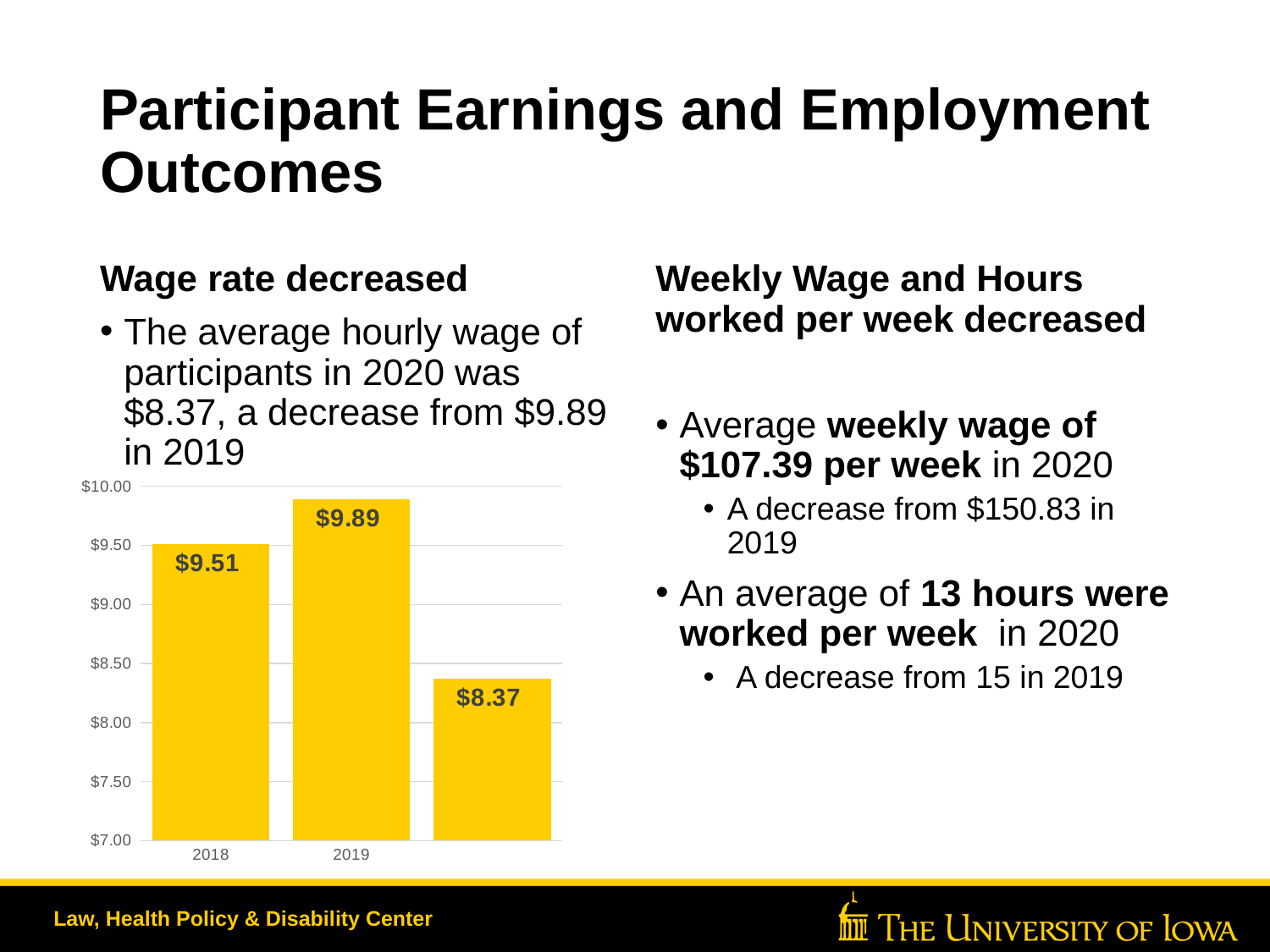
What is the value shown on the rightmost bar in the chart? $8.37 Is the value for 2018 greater or less than $9.00? greater Which labelled year has the highest bar in the chart? 2019 What is the value of the 2019 bar in the chart? $9.89 Does the value rise or fall from 2018 to 2019? rise What is the difference between the 2019 bar and the 2018 bar? $0.38 What kind of chart is shown on the slide? bar chart How many bars are plotted in the chart? 3 What is the value of the lowest bar in the chart? $8.37 What is the difference between the 2019 bar and the rightmost bar? $1.52 What is the value of the 2018 bar in the chart? $9.51 Which is larger, the 2018 bar or the 2019 bar? 2019